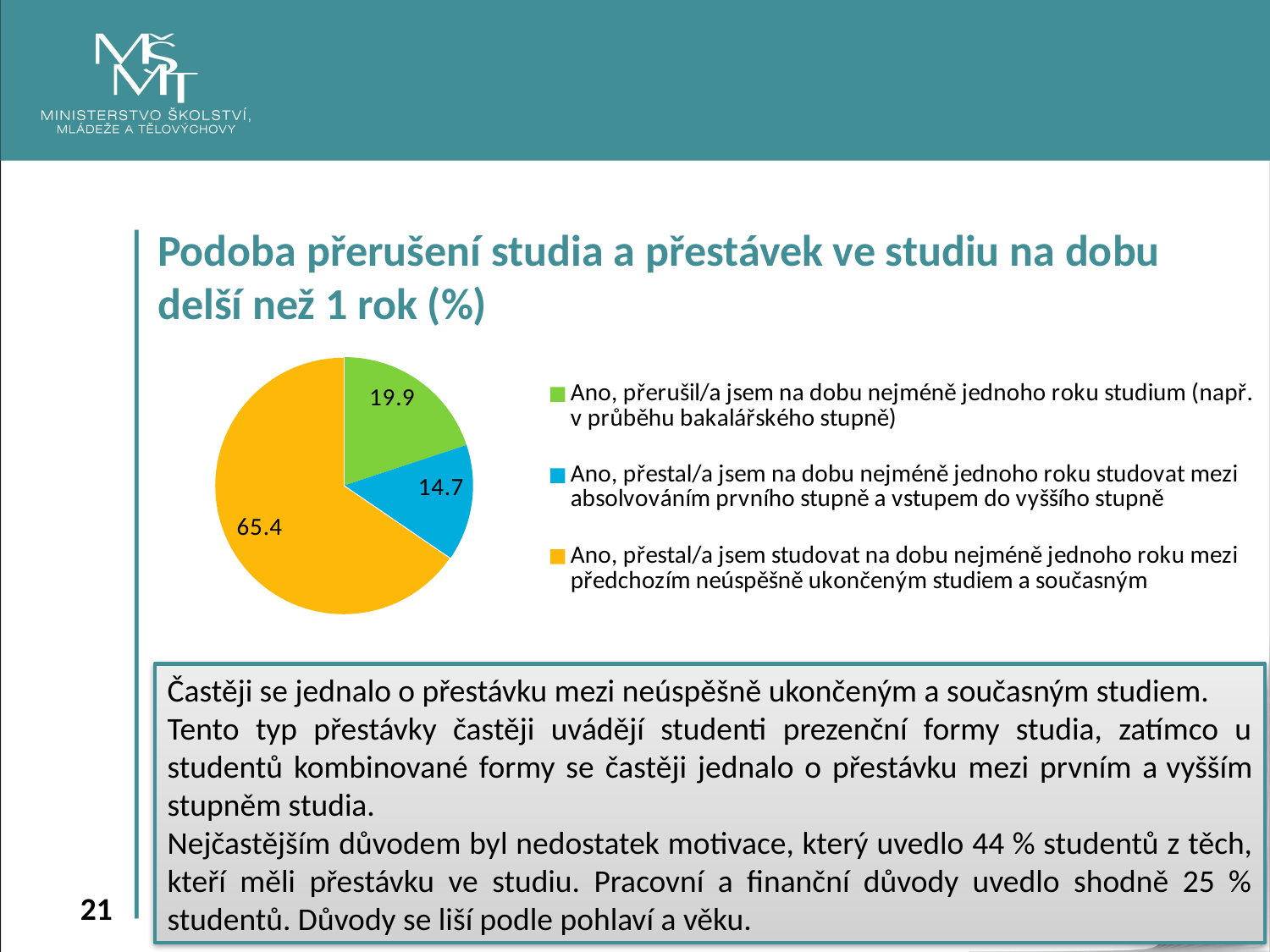
What is the value of the slice for 'Ano, přestal/a jsem studovat na dobu nejméně jednoho roku mezi předchozím neúspěšně ukončeným studiem a současným'? 65.4 Which is larger: the green slice or the blue slice? the green slice How many slices does the pie chart have? 3 What is the value of the slice for 'Ano, přerušil/a jsem na dobu nejméně jednoho roku studium (např. v průběhu bakalářského stupně)'? 19.9 What is the difference between the green slice (19.9) and the blue slice (14.7)? 5.2 What kind of chart is shown on the slide? pie chart What is the value of the slice for 'Ano, přestal/a jsem na dobu nejméně jednoho roku studovat mezi absolvováním prvního stupně a vstupem do vyššího stupně'? 14.7 Which category has the largest slice in the pie chart? Ano, přestal/a jsem studovat na dobu nejméně jednoho roku mezi předchozím neúspěšně ukončeným studiem a současným What colour is the largest slice of the pie chart? yellow What share of the pie does the yellow slice represent? 65.4 What is the difference between the largest slice (65.4) and the green slice (19.9)? 45.5 Which category has the smallest slice in the pie chart? Ano, přestal/a jsem na dobu nejméně jednoho roku studovat mezi absolvováním prvního stupně a vstupem do vyššího stupně